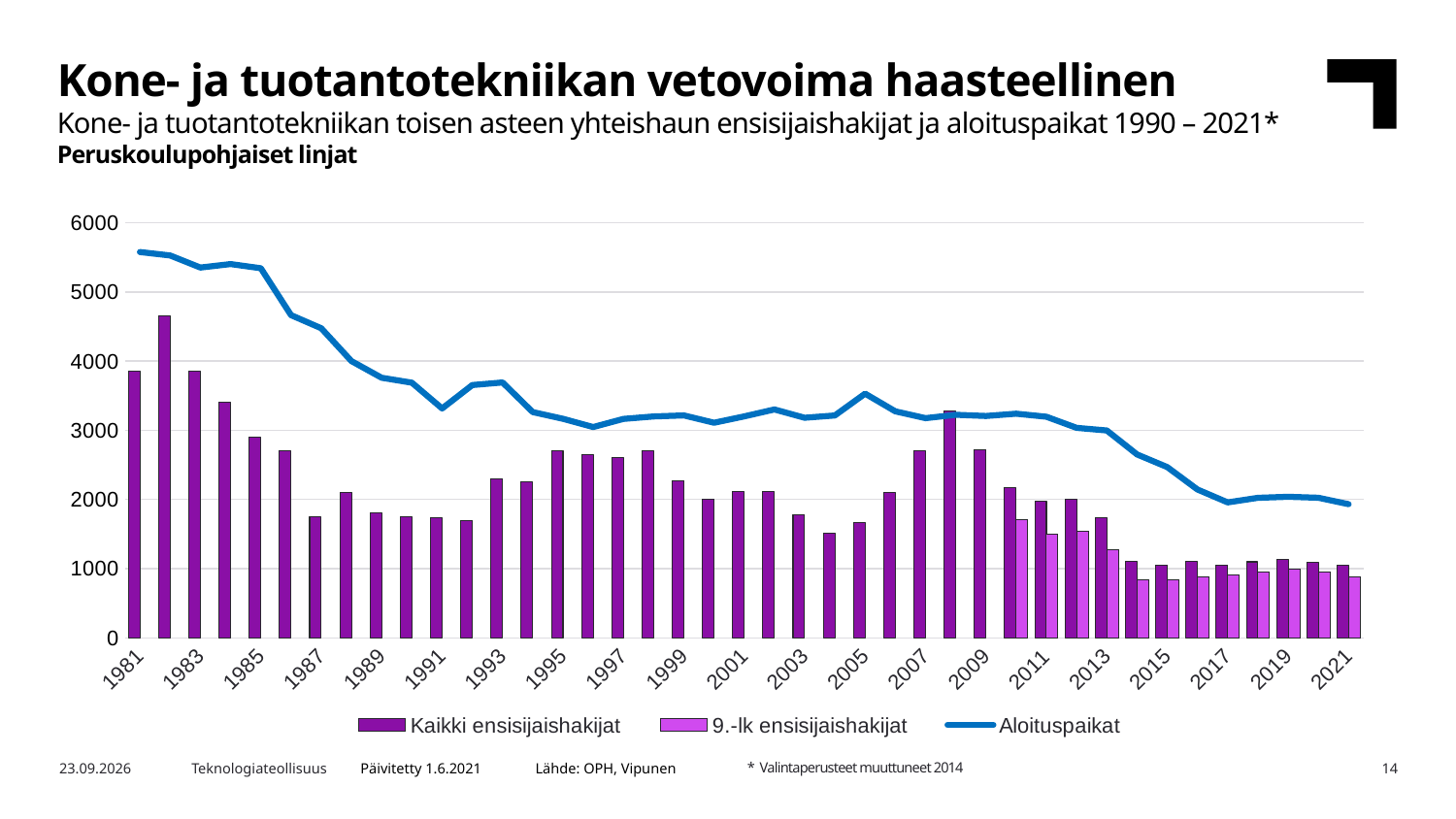
What is the title of the chart's slide? Kone- ja tuotantotekniikan vetovoima haasteellinen Is the Aloituspaikat value for 1981 greater or less than 5000? greater Is the Aloituspaikat value for 2015 greater or less than 2000? greater Is the 9.-lk ensisijaishakijat value for 2021 greater or less than 1000? less Which is larger, the Aloituspaikat value for 1981 or for 2021? 1981 What kind of chart is shown on the slide? A combined bar and line chart How many series does the legend list? 3 Does the Aloituspaikat line rise or fall overall from 1981 to 2021? Fall Which series is drawn as a line rather than bars? Aloituspaikat In which year is the Kaikki ensisijaishakijat bar highest? 1982